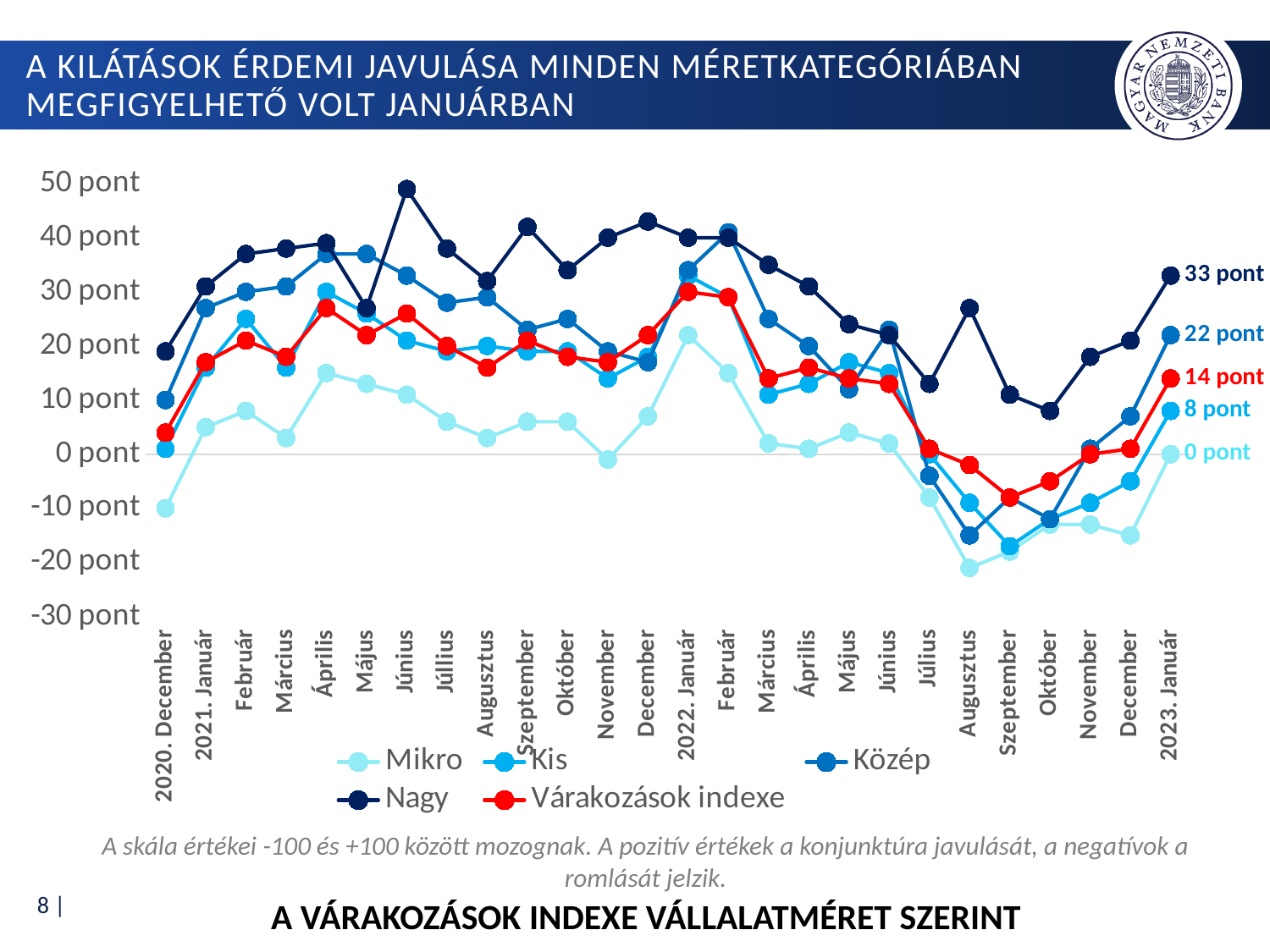
Which series has the highest value in 2023. Január? Nagy Is the value for the Nagy series in Június 2021 greater or less than 40 pont? greater What is the difference between the Nagy and Közép values in 2023. Január? 11 pont How many series does the legend list? 5 Which series has the lowest value in 2023. Január? Mikro In 2023. Január, which is larger: the Kis value or the Mikro value? Kis What is the value of the Várakozások indexe series in 2023. Január? 14 pont What is the value of the Nagy series in 2023. Január? 33 pont Is the value for the Mikro series in 2020. December greater or less than 0 pont? less How many months are shown on the x axis? 26 What is the value of the Mikro series in 2023. Január? 0 pont What kind of chart is shown on the slide? Line chart